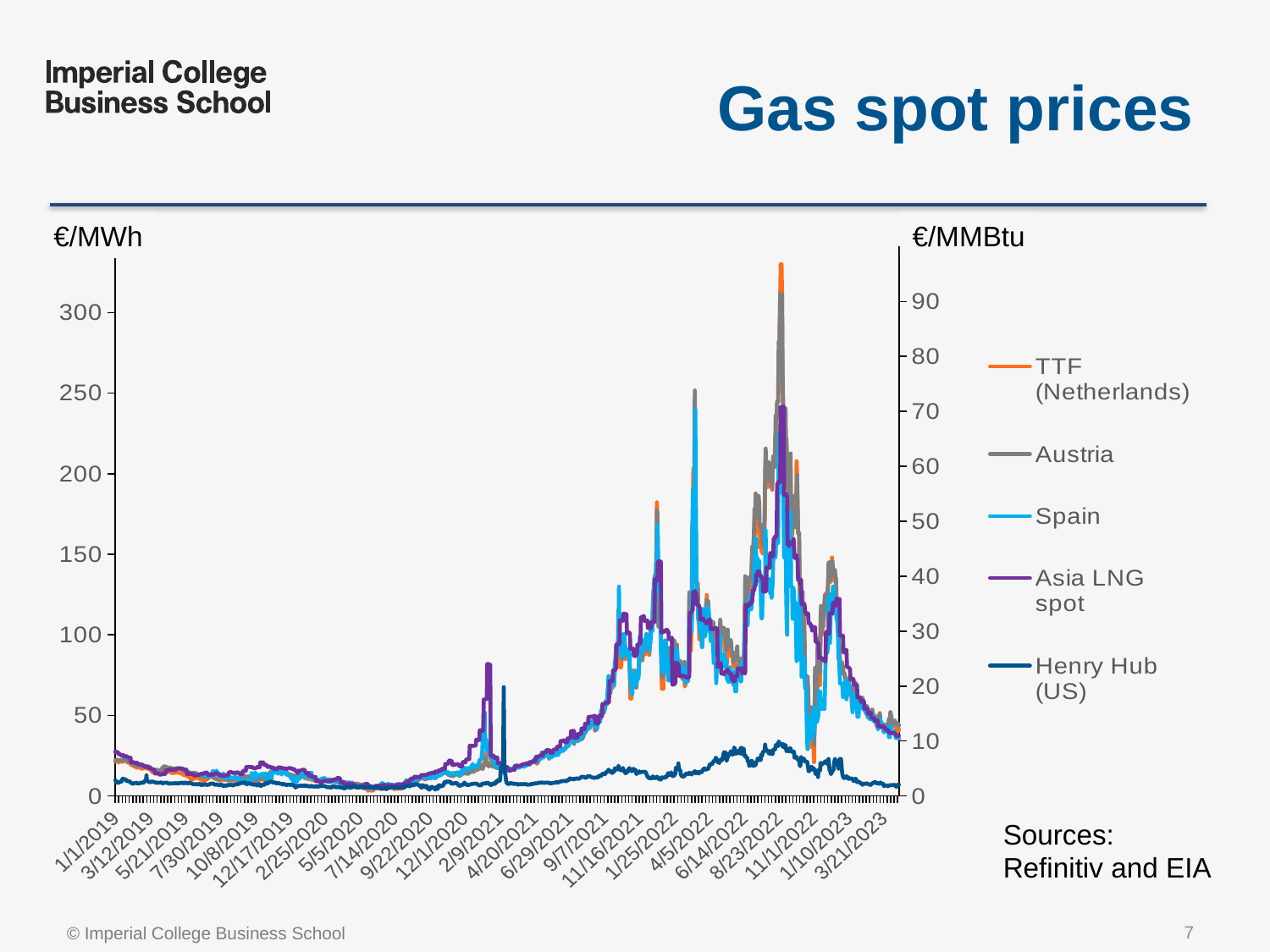
Is the peak value of TTF (Netherlands) around 8/23/2022 greater or less than 300 €/MWh? greater Do the European gas prices rise or fall between 2/9/2021 and 8/23/2022? rise Do the European gas prices rise or fall between 8/23/2022 and 3/21/2023? fall Is the highest value of Henry Hub (US) greater or less than 100 €/MWh? less How many series does the legend list? 5 Is the peak value of Asia LNG spot around 8/23/2022 greater or less than 200 €/MWh? greater What kind of chart is shown on the slide? Line chart At the peak around 8/23/2022, which is larger: TTF (Netherlands) or Henry Hub (US)? TTF (Netherlands) What unit is shown on the left vertical axis? €/MWh What sources are cited for the chart? Refinitiv and EIA